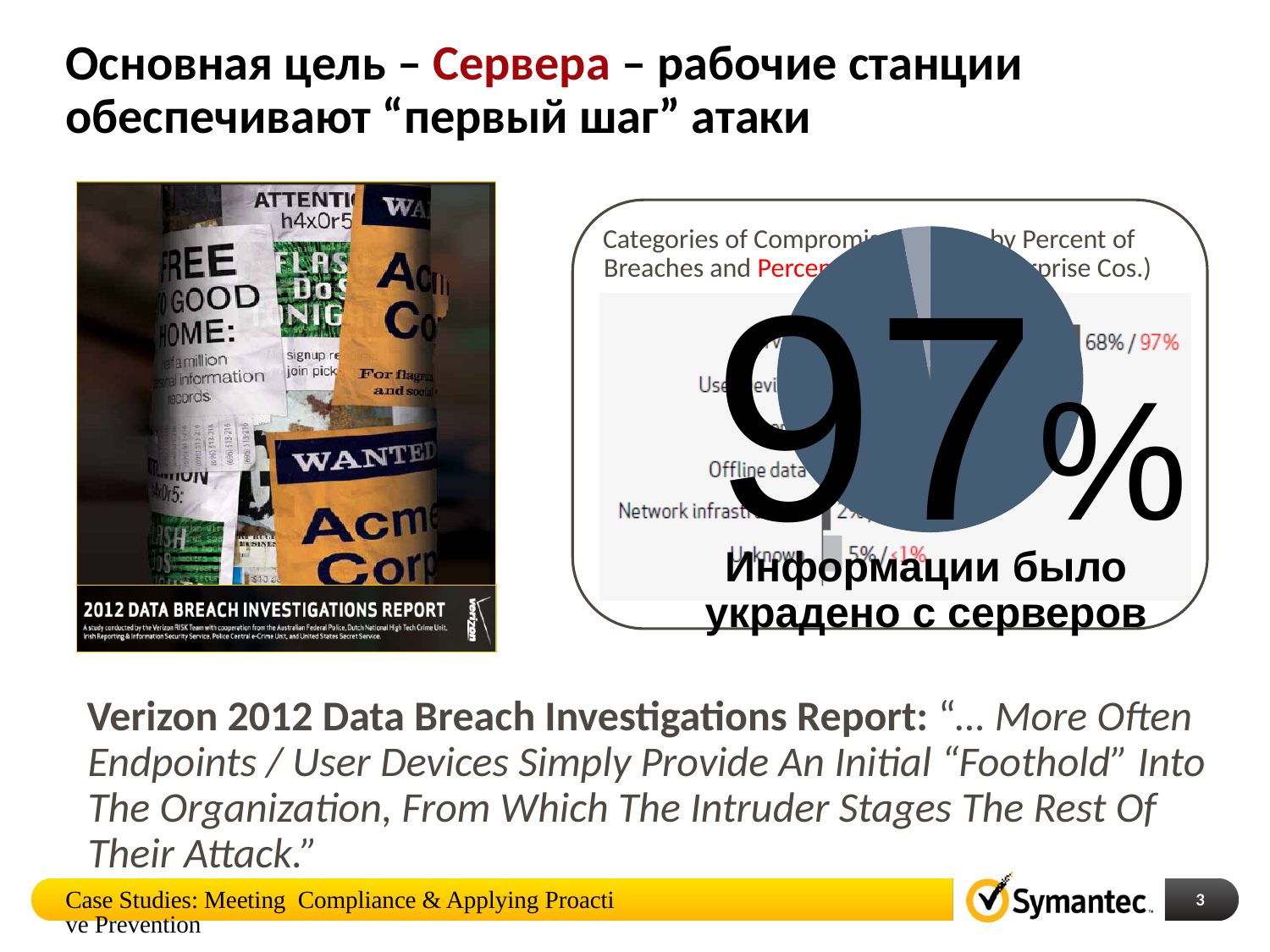
Which slice of the pie chart on the right is larger, the dark blue one or the light grey one? dark blue Which report is cited as the source of the chart on the right of the slide? Verizon 2012 Data Breach Investigations Report What Russian caption is written below the pie chart on the right of the slide? Информации было украдено с серверов How many slices does the pie chart on the right of the slide have? 2 What large percentage is printed over the pie chart on the right of the slide? 97% What kind of chart is shown inside the rounded box on the right of the slide, overlaid with the large number? pie chart What kind of chart is shown in the background behind the pie chart on the right of the slide? bar chart In the bar chart behind the pie, what values are printed next to the top row? 68% / 97% In the bar chart behind the pie, what values are printed next to the Unknown row? 5% / <1%